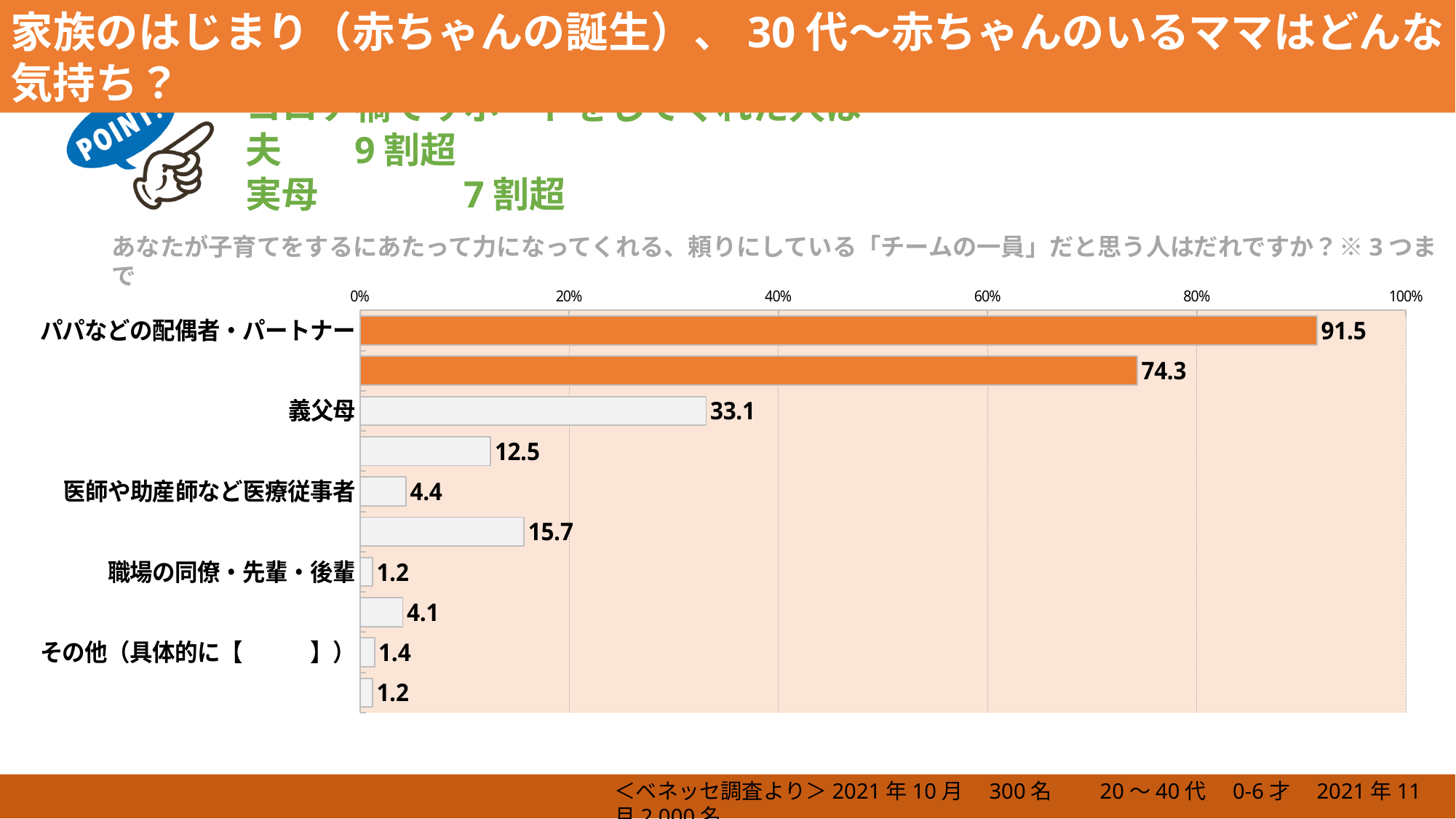
What is the value for パパなどの配偶者・パートナー? 91.5 What is the value for その他（具体的に【 】）? 1.4 How many bars are plotted in the chart? 10 Is the value for 義父母 greater or less than 20%? greater What is the value for 職場の同僚・先輩・後輩? 1.2 What is the value for 義父母? 33.1 Which category has the highest value? パパなどの配偶者・パートナー What is the difference between the values for 義父母 and 医師や助産師など医療従事者? 28.7 What kind of chart is shown on the slide? bar chart Which is larger, the value for 義父母 or the value for 医師や助産師など医療従事者? 義父母 What is the difference between the values for パパなどの配偶者・パートナー and 義父母? 58.4 What is the value for 医師や助産師など医療従事者? 4.4